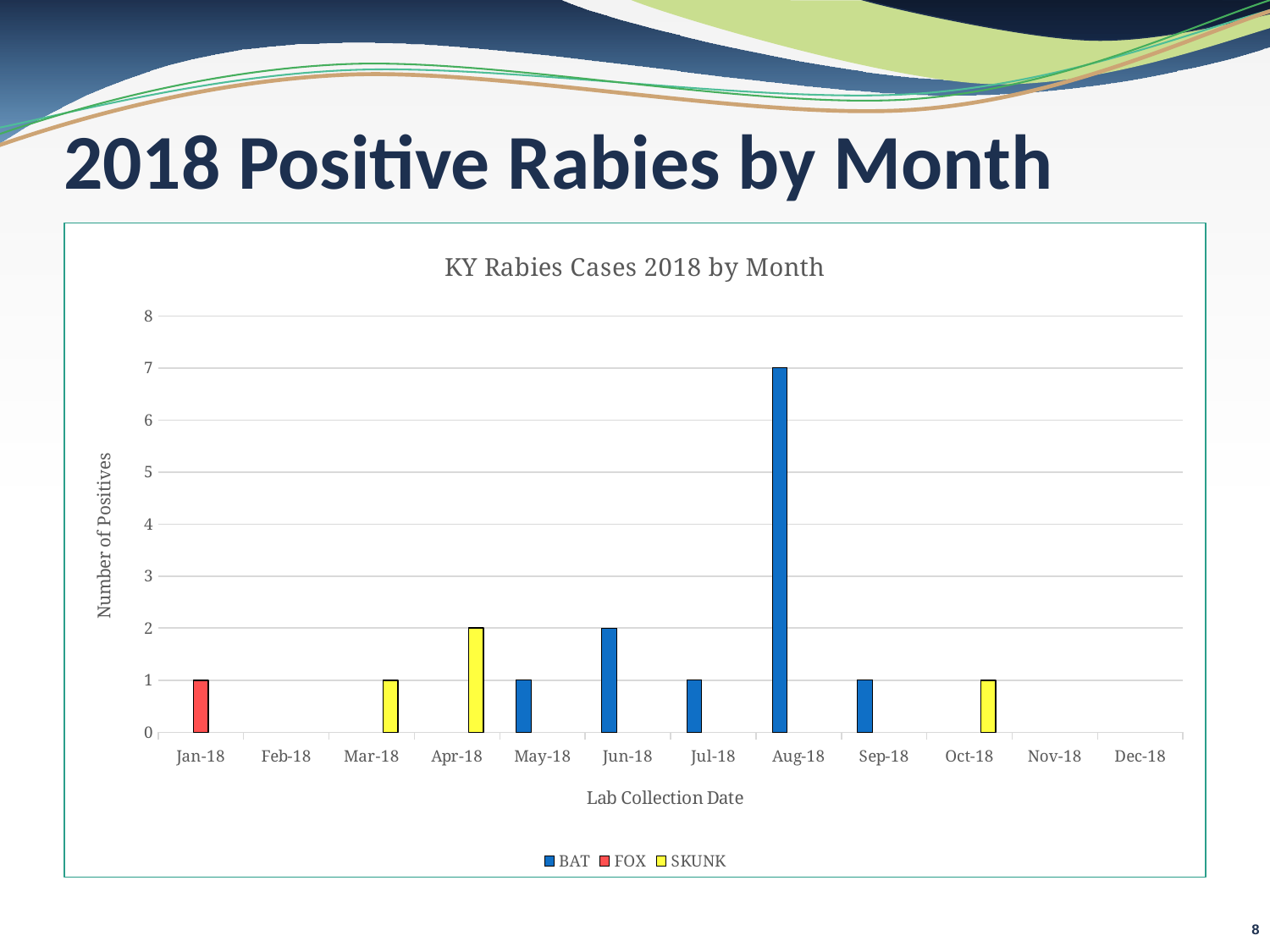
What is the title of the chart? KY Rabies Cases 2018 by Month What is the label of the y axis? Number of Positives How many positives are shown for BAT in Aug-18? 7 How many positives are shown for SKUNK in Apr-18? 2 What is the difference between the BAT value in Aug-18 and the BAT value in Jun-18? 5 Which is larger, the SKUNK value in Apr-18 or the SKUNK value in Mar-18? Apr-18 How many months are shown on the x axis? 12 What type of chart is shown on the slide? bar chart Which month has the highest number of positives? Aug-18 How many positives are shown for FOX in Jan-18? 1 How many series does the legend list? 3 Is the BAT value for Aug-18 greater or less than 5? greater